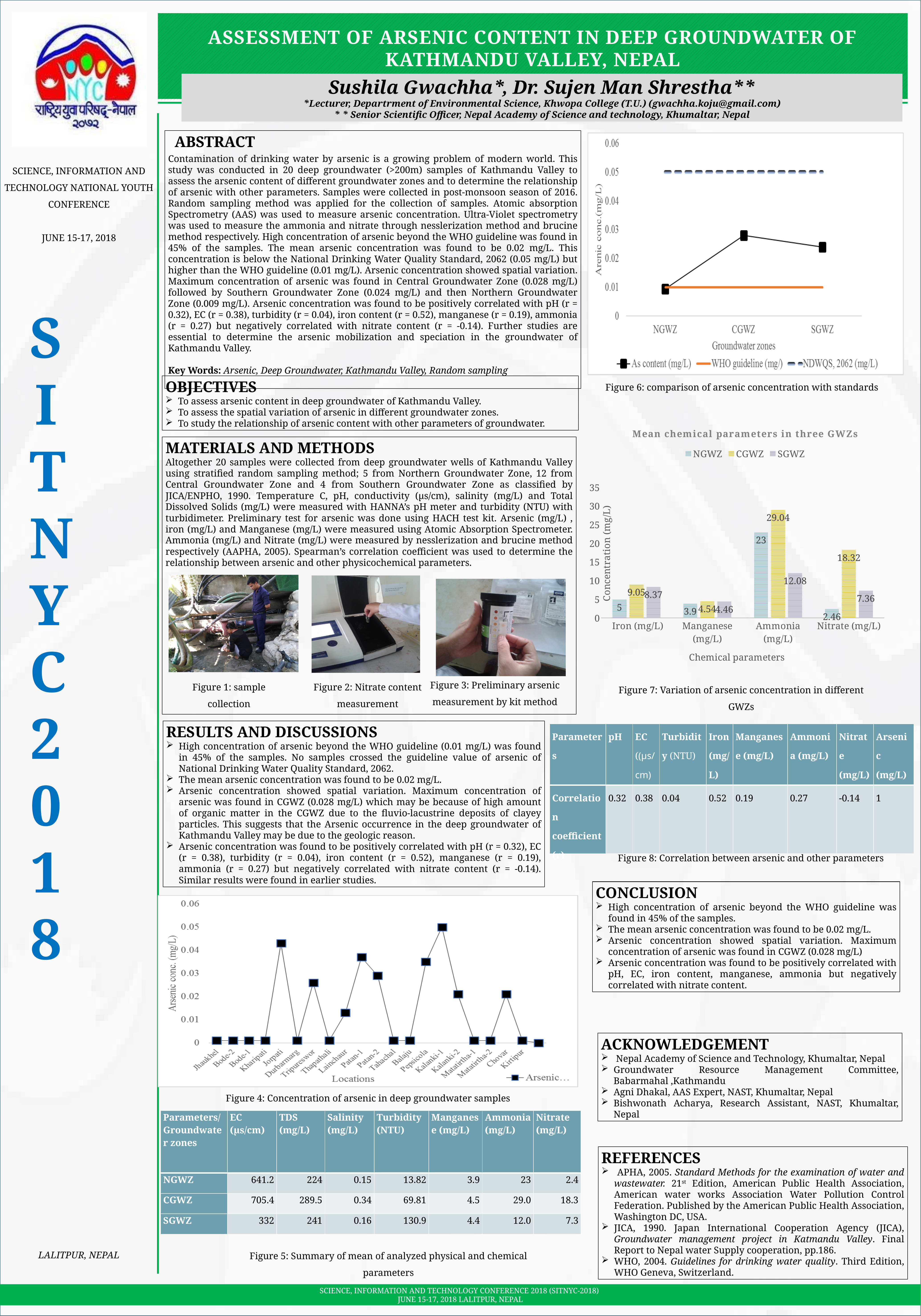
In the 'Mean chemical parameters in three GWZs' chart, what is the difference between the Ammonia (mg/L) values for CGWZ and NGWZ? 6.04 In the 'Mean chemical parameters in three GWZs' chart, what is the Ammonia (mg/L) value for CGWZ? 29.04 In the 'Mean chemical parameters in three GWZs' chart, what is the Nitrate (mg/L) value for SGWZ? 7.36 How many series does the legend of the 'Mean chemical parameters in three GWZs' chart list? 3 In the 'Mean chemical parameters in three GWZs' chart, which is larger: the Iron (mg/L) value for CGWZ or for SGWZ? CGWZ In Figure 6 (comparison of arsenic concentration with standards), is the NDWQS, 2062 line greater or less than 0.04? greater In the 'Mean chemical parameters in three GWZs' chart, which groundwater zone has the lowest Ammonia (mg/L) value? SGWZ What kind of chart is the 'Mean chemical parameters in three GWZs' chart? Bar chart In the 'Mean chemical parameters in three GWZs' chart, what is the Iron (mg/L) value for NGWZ? 5 In Figure 6 (comparison of arsenic concentration with standards), is the As content value for CGWZ greater or less than 0.02? greater In the 'Mean chemical parameters in three GWZs' chart, which groundwater zone has the highest Nitrate (mg/L) value? CGWZ How many locations are shown on the x axis of Figure 4 (Concentration of arsenic in deep groundwater samples)? 20